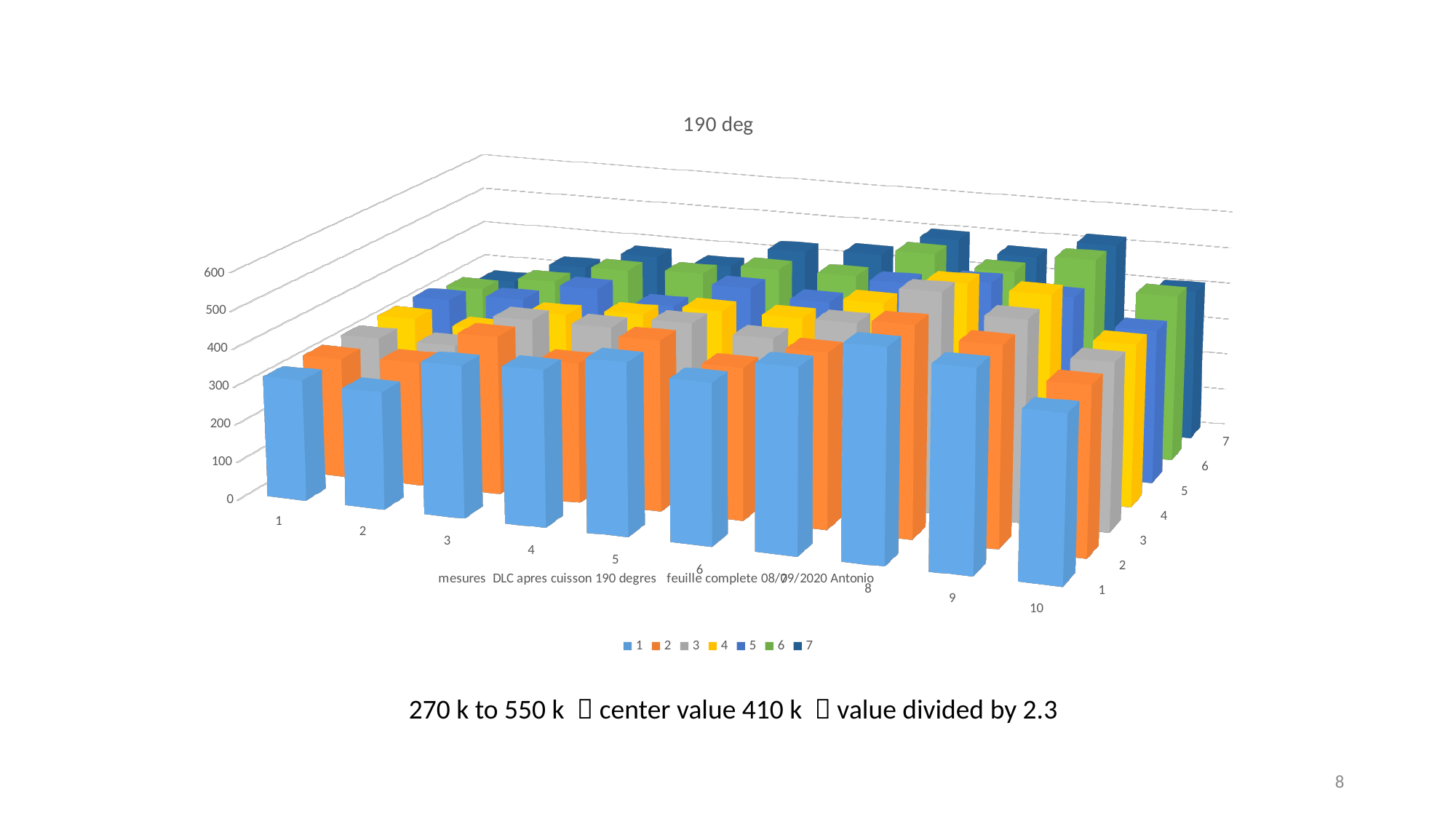
What is the title of the chart? 190 deg What kind of chart is shown on the slide? bar chart What colour is series 2 in the chart? orange How many series does the legend list? 7 What is the highest tick value shown on the vertical axis? 600 How many categories are shown along the x axis of the chart? 10